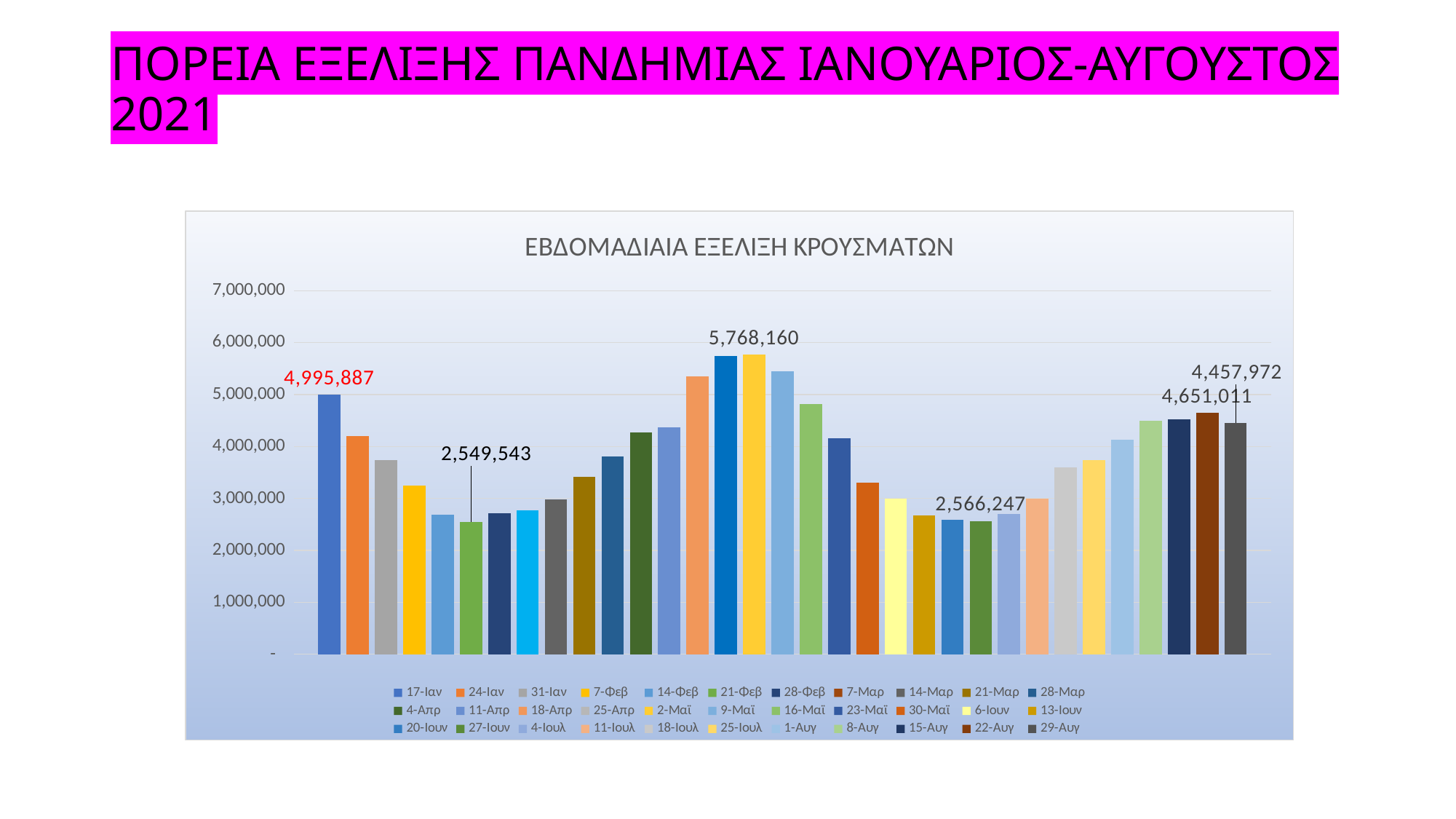
What is the title of the chart? ΕΒΔΟΜΑΔΙΑΙΑ ΕΞΕΛΙΞΗ ΚΡΟΥΣΜΑΤΩΝ What is the value labeled for 21-Φεβ? 2,549,543 What kind of chart is shown on the slide? bar chart Which week has the lowest labeled value? 21-Φεβ What is the value labeled for 17-Ιαν? 4,995,887 What is the highest value labeled on the chart? 5,768,160 What is the difference between the labeled values for 22-Αυγ and 29-Αυγ? 193,039 How many entries does the legend list? 33 What is the value labeled for 22-Αυγ? 4,651,011 Which is larger, the value for 17-Ιαν or the value for 24-Ιαν? 17-Ιαν Is the value for 18-Απρ greater or less than 5,000,000? greater What is the value labeled for 29-Αυγ? 4,457,972